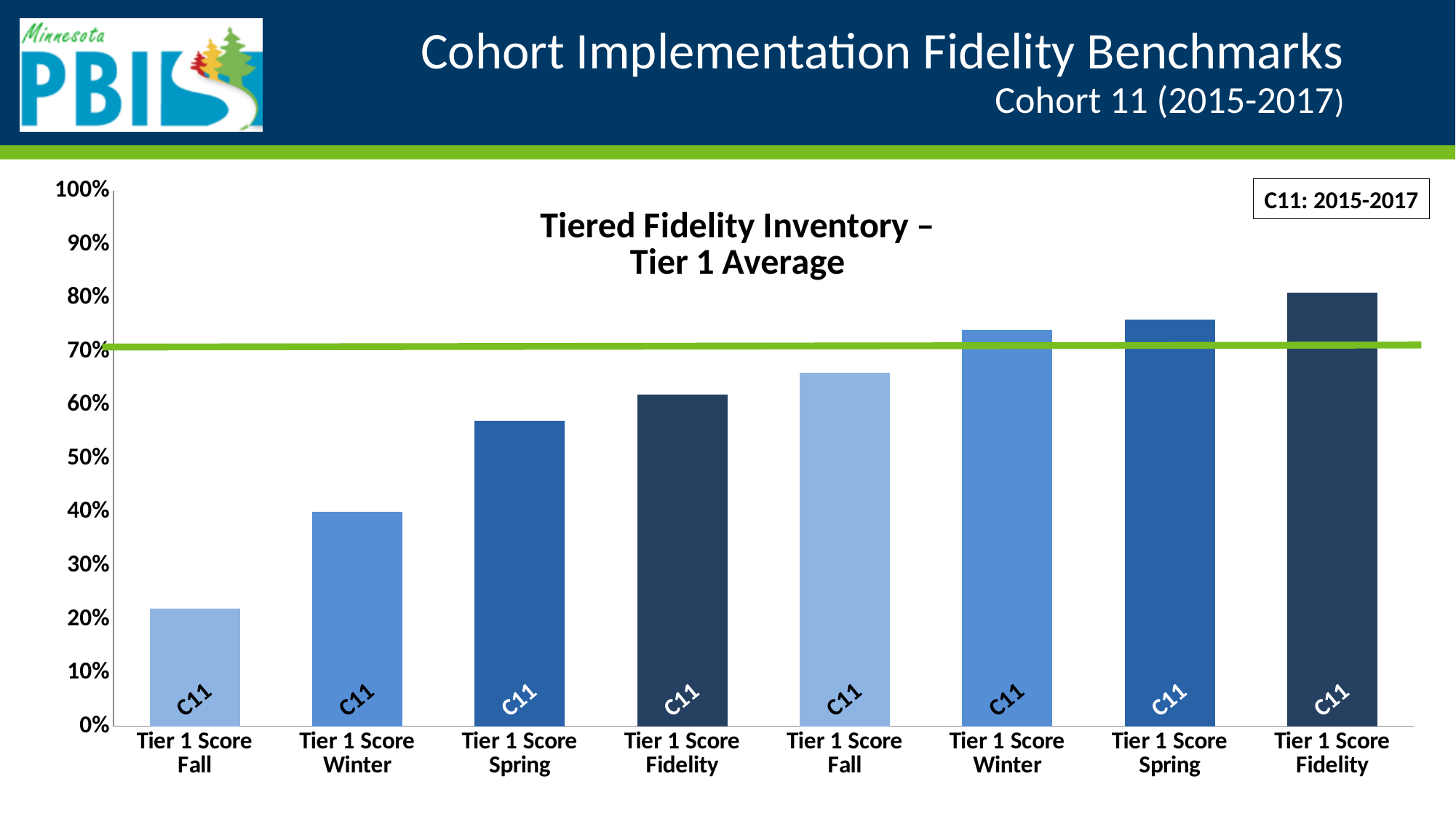
What is the title of the chart? Tiered Fidelity Inventory – Tier 1 Average Is the value of the rightmost Tier 1 Score Fidelity bar greater or less than 70%? greater What label appears in the box at the top right of the chart? C11: 2015-2017 Which bar is the tallest in the chart? the rightmost Tier 1 Score Fidelity bar Do the bar values rise or fall from left to right across the chart? rise How many bars are plotted in the chart? 8 What kind of chart is shown on the slide? bar chart Which is larger, the first Tier 1 Score Fidelity bar or the second Tier 1 Score Fidelity bar? the second Tier 1 Score Fidelity bar Is the value of the first Tier 1 Score Fall bar greater or less than 30%? less Is the value of the first Tier 1 Score Spring bar greater or less than 50%? greater Which bar is the shortest in the chart? the leftmost Tier 1 Score Fall bar